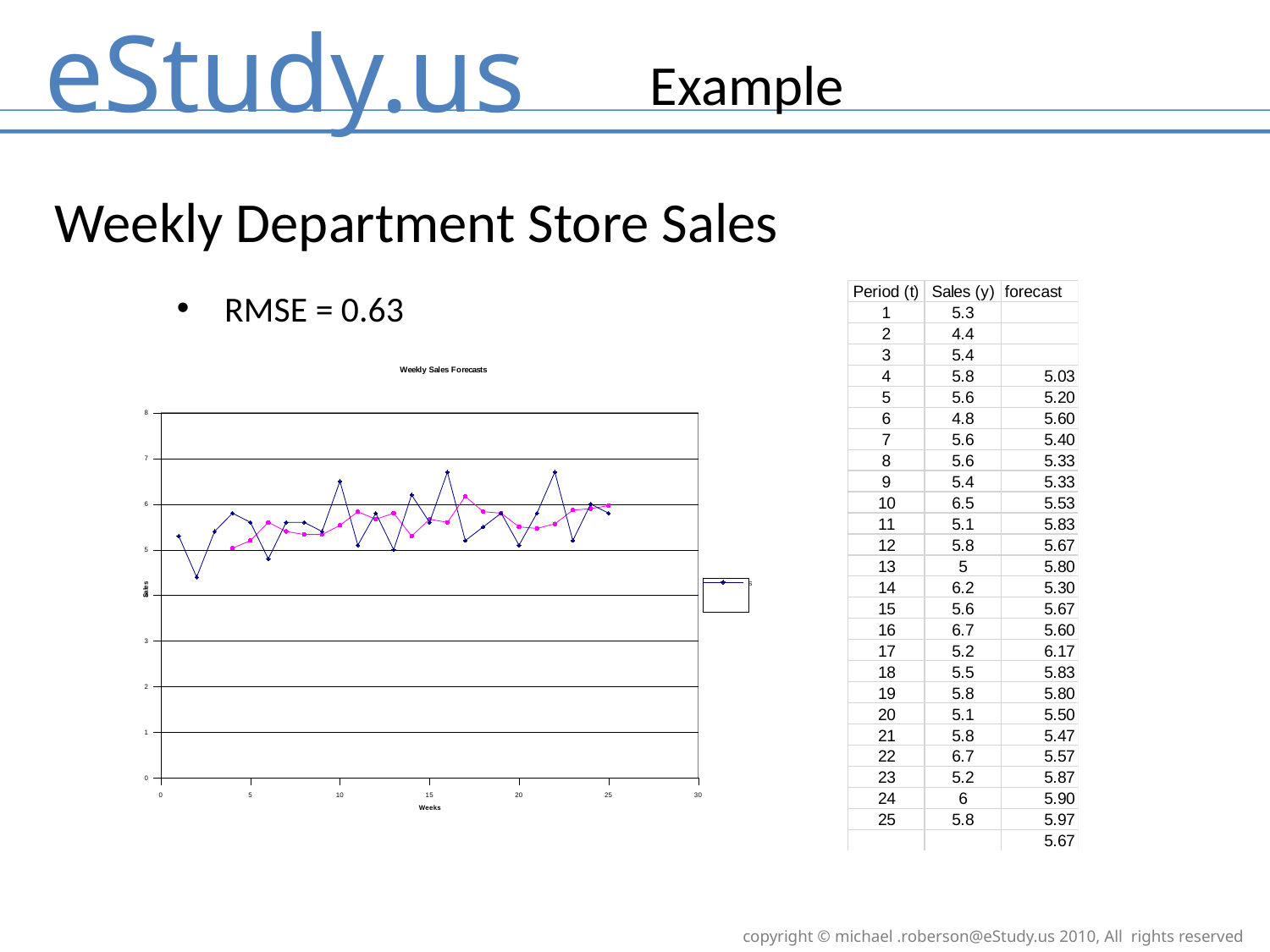
What is the label on the x axis of the chart? Weeks Is the sales value plotted at week 2 greater or less than 5? less What is the title of the chart? Weekly Sales Forecasts At which week does the sales line reach its lowest point? 2 Is the sales value plotted at week 16 greater or less than 6? greater According to the table on the slide, what is the forecast for period 17? 6.17 According to the table on the slide, what is the sales value for period 10? 6.5 How many lines (series) are plotted on the chart? 2 What type of chart is shown on the slide? line chart Which is larger, the sales value at week 10 or the sales value at week 11? week 10 Is the sales value plotted at week 6 greater or less than 5? less How many periods of sales data are plotted on the chart? 25